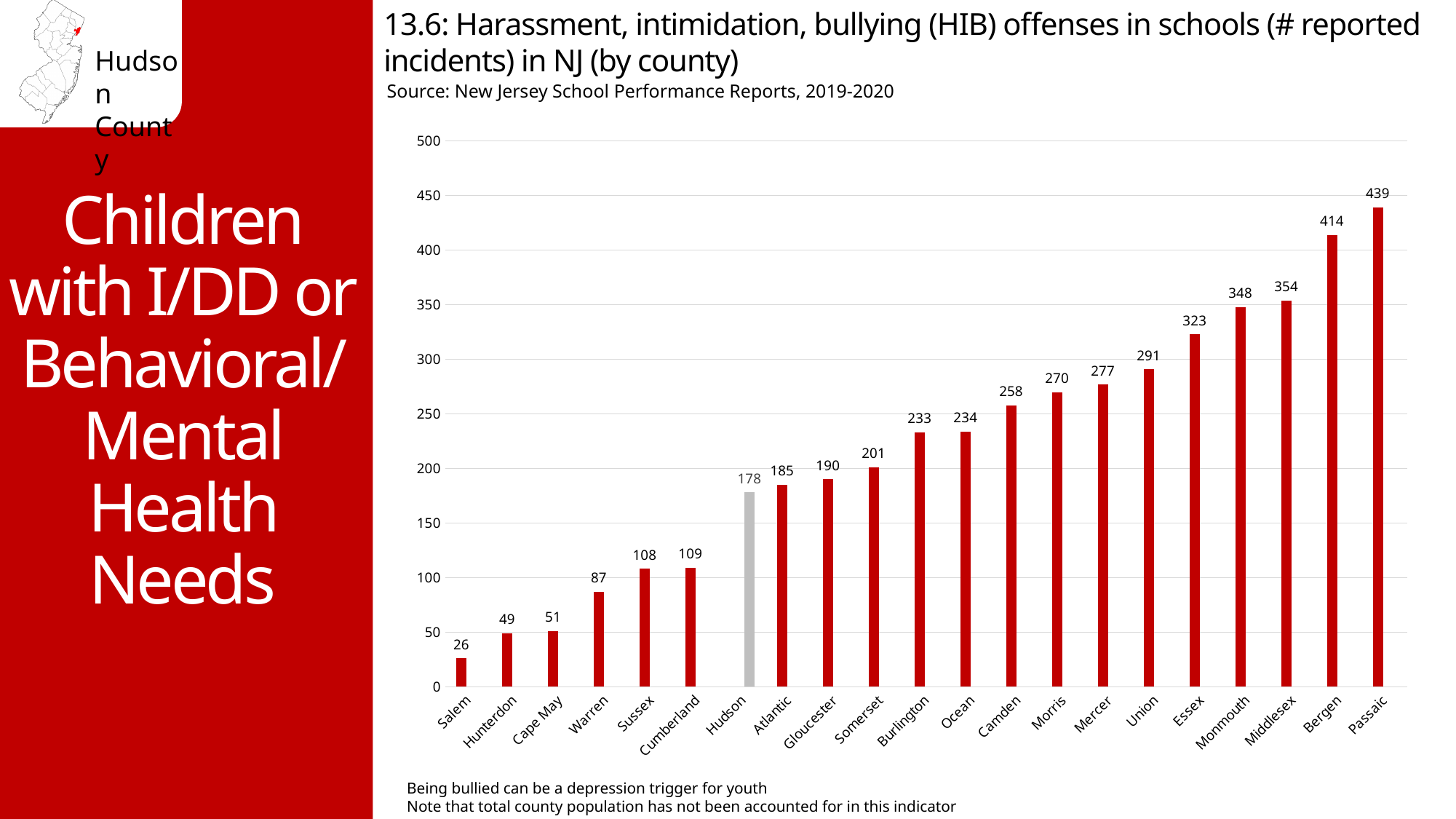
Is the value for Union County greater or less than 250? greater Which county has the highest number of reported HIB incidents? Passaic What is the difference in reported HIB incidents between Passaic and Bergen? 25 What is the difference in reported HIB incidents between Hudson and Salem? 152 What is the number of reported HIB incidents for Bergen County? 414 Which county has more reported HIB incidents, Essex or Monmouth? Monmouth What is the number of reported HIB incidents for Warren County? 87 Which county's bar is shown in gray rather than red? Hudson What kind of chart is shown on the slide? Bar chart Which county has the lowest number of reported HIB incidents? Salem How many counties are shown on the chart? 21 What is the number of reported HIB incidents for Hudson County? 178